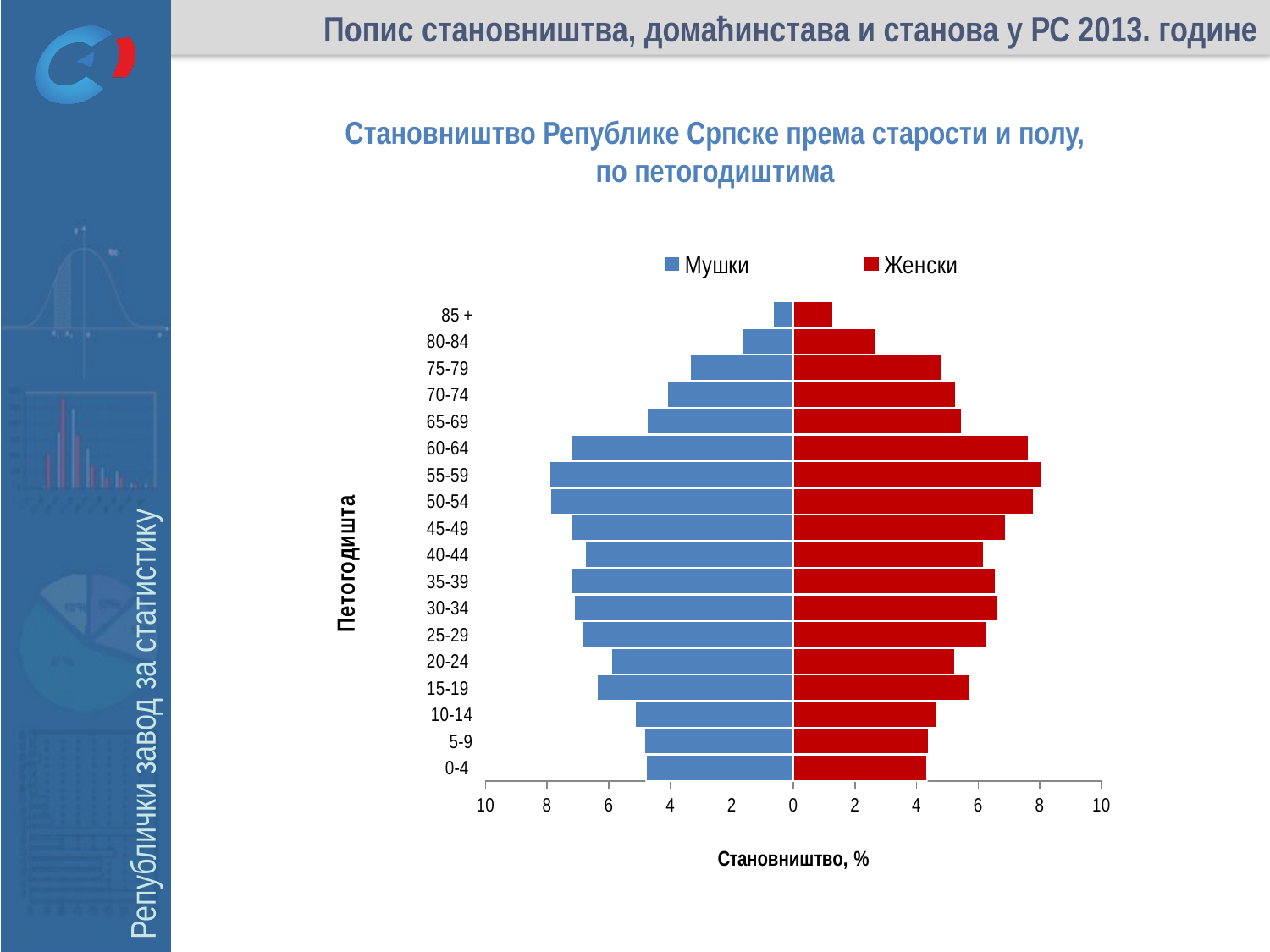
How many series does the chart legend list? 2 What is the label of the horizontal axis of the chart? Становништво, % Which age group has the lowest value for the Женски series? 85 + Is the Мушки value for the 55-59 age group greater or less than 6? greater How many age groups (categories) are shown on the vertical axis of the chart? 18 What kind of chart is shown on the slide? bar chart For the 15-19 age group, which series has the larger value, Мушки or Женски? Мушки For the 85 + age group, which series has the larger value, Мушки or Женски? Женски Is the Женски value for the 60-64 age group greater or less than 6? greater Is the Мушки value for the 85 + age group greater or less than 2? less Which age group has the lowest value for the Мушки series? 85 +